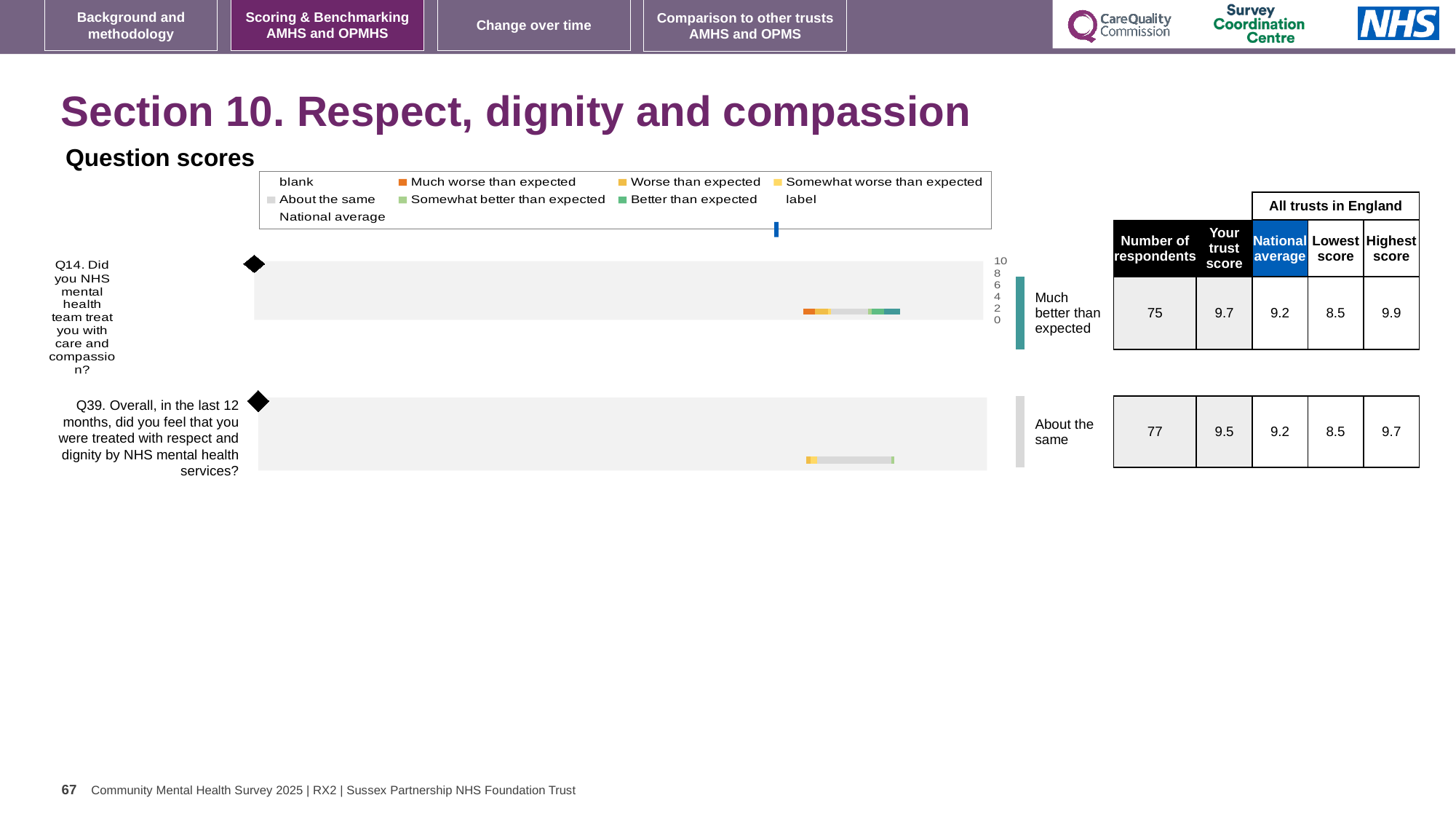
What is the number of respondents for Q14? 75 What is the trust score for Q39 in the table beside the chart? 9.5 What is the trust score for Q14 in the table beside the chart? 9.7 What is the highest score across all trusts in England for Q39? 9.7 How many entries does the legend of the question scores chart list? 9 What is the difference between the highest score and the lowest score for Q39? 1.2 What is the difference between the trust score and the national average for Q14? 0.5 Which question has the higher trust score, Q14 or Q39? Q14 Which benchmark rating is shown next to the bar for Q39? About the same What kind of chart is used to show the question scores on this slide? bar chart How many questions (categories) are plotted in the question scores chart? 2 Which benchmark rating is shown next to the bar for Q14? Much better than expected